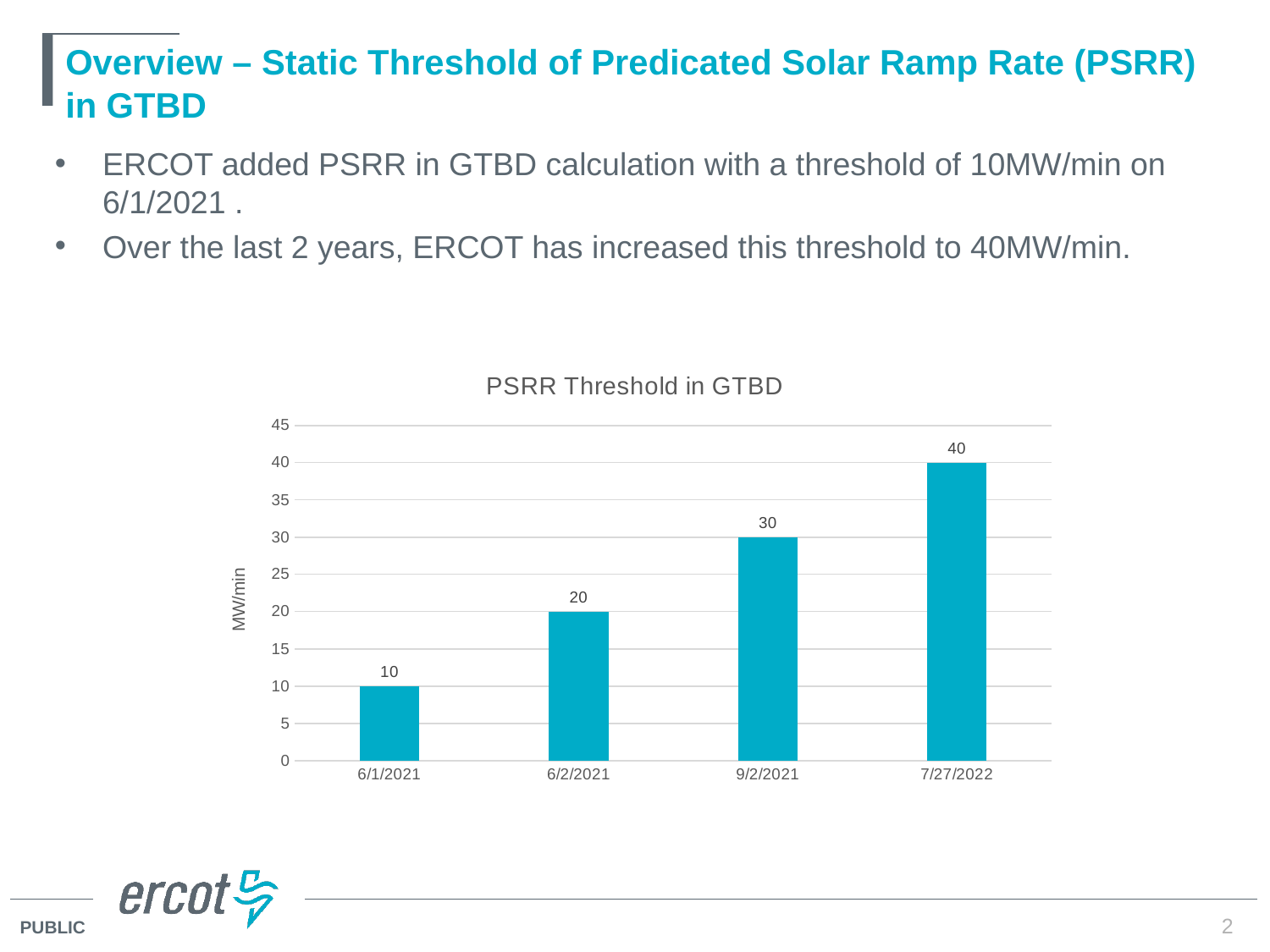
What is the PSRR threshold value shown for 9/2/2021? 30 How many dates are shown on the x axis of the chart? 4 What is the PSRR threshold value shown for 7/27/2022? 40 Do the PSRR threshold values rise or fall from left to right along the x axis? Rise Which date has the highest PSRR threshold in the chart? 7/27/2022 What is the PSRR threshold value shown for 6/1/2021? 10 Which date has the lowest PSRR threshold in the chart? 6/1/2021 What kind of chart is used to show the PSRR threshold in GTBD? Bar chart What is the difference between the PSRR threshold on 7/27/2022 and on 6/1/2021? 30 What is the difference between the PSRR threshold on 9/2/2021 and on 6/2/2021? 10 What is the label on the vertical axis of the chart? MW/min Which is larger, the PSRR threshold on 6/2/2021 or on 9/2/2021? 9/2/2021